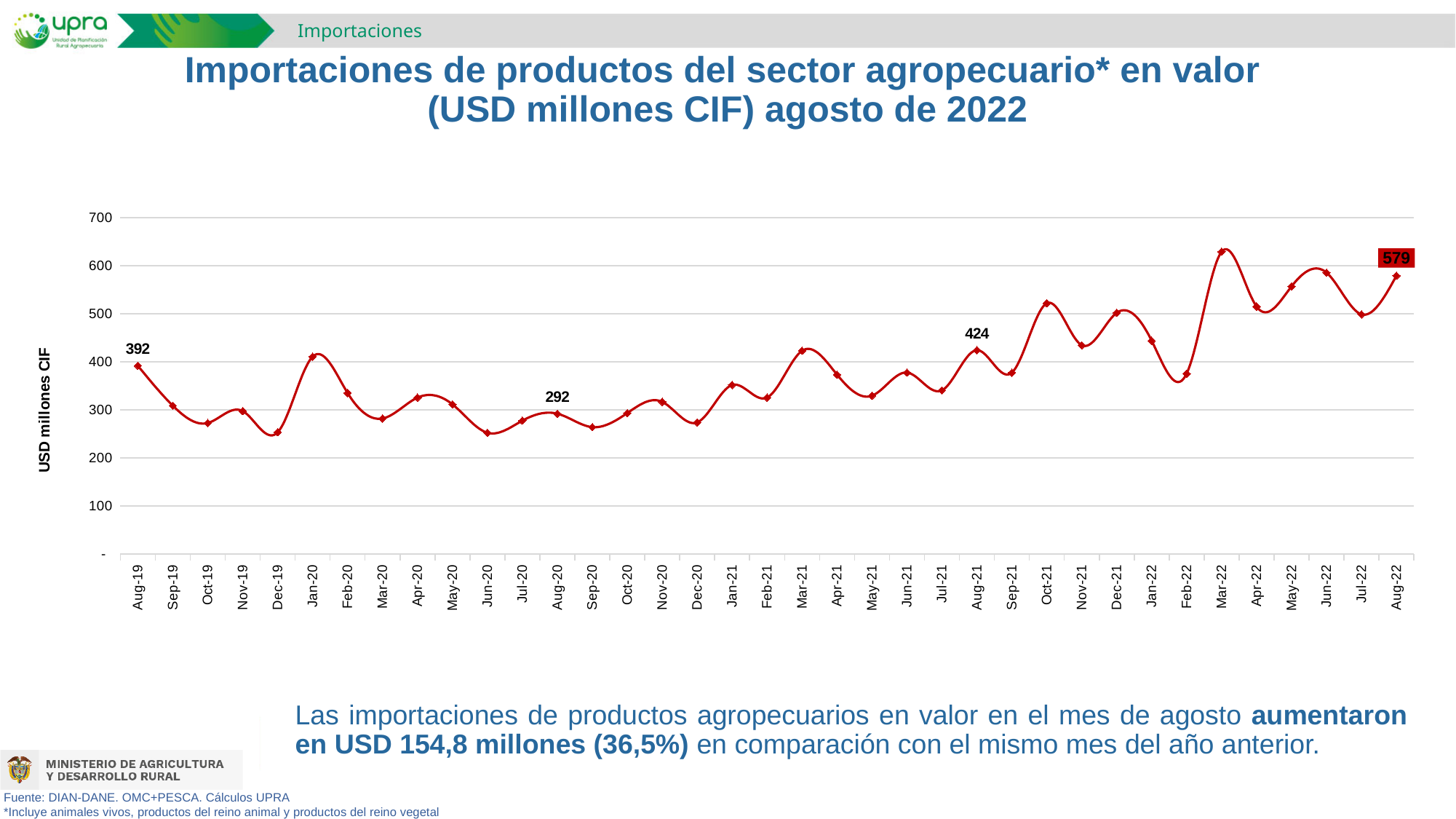
Which month has the highest value on the chart? Mar-22 What is the difference between the values for Aug-22 and Aug-21? 155 How many monthly data points are plotted on the chart? 37 Is the value for Feb-22 greater or less than 400? less What is the value for Aug-21? 424 What is the value for Aug-20? 292 Is the value for Mar-22 greater or less than 600? greater What is the difference between the values for Aug-19 and Aug-20? 100 What is the value for Aug-22? 579 What kind of chart is shown on the slide? Line chart What is the value for Aug-19? 392 Which is larger, the value for Aug-21 or the value for Aug-19? Aug-21